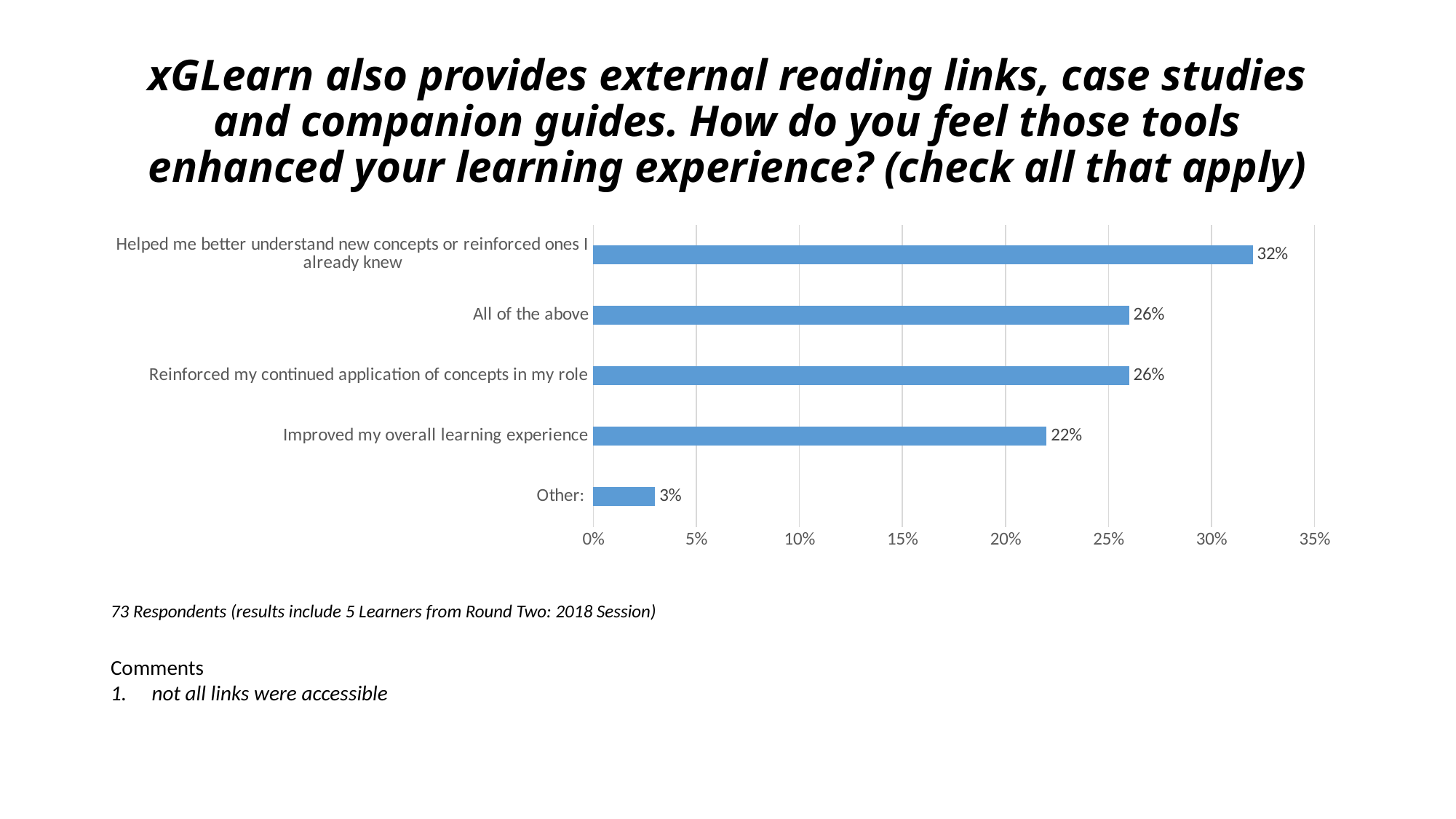
What is the value for "Improved my overall learning experience"? 22% What percentage of respondents selected "Helped me better understand new concepts or reinforced ones I already knew"? 32% Which is larger: the value for "All of the above" or the value for "Improved my overall learning experience"? All of the above Which category has the highest value? Helped me better understand new concepts or reinforced ones I already knew What is the difference between the values for "Helped me better understand new concepts or reinforced ones I already knew" and "Improved my overall learning experience"? 10% What is the value for "All of the above"? 26% Is the value for "Improved my overall learning experience" greater or less than 25%? less What is the difference between the values for "Reinforced my continued application of concepts in my role" and "Other:"? 23% What is the value for "Other:"? 3% Which category has the lowest value? Other: What kind of chart is shown on the slide? Bar chart How many categories are shown in the chart? 5